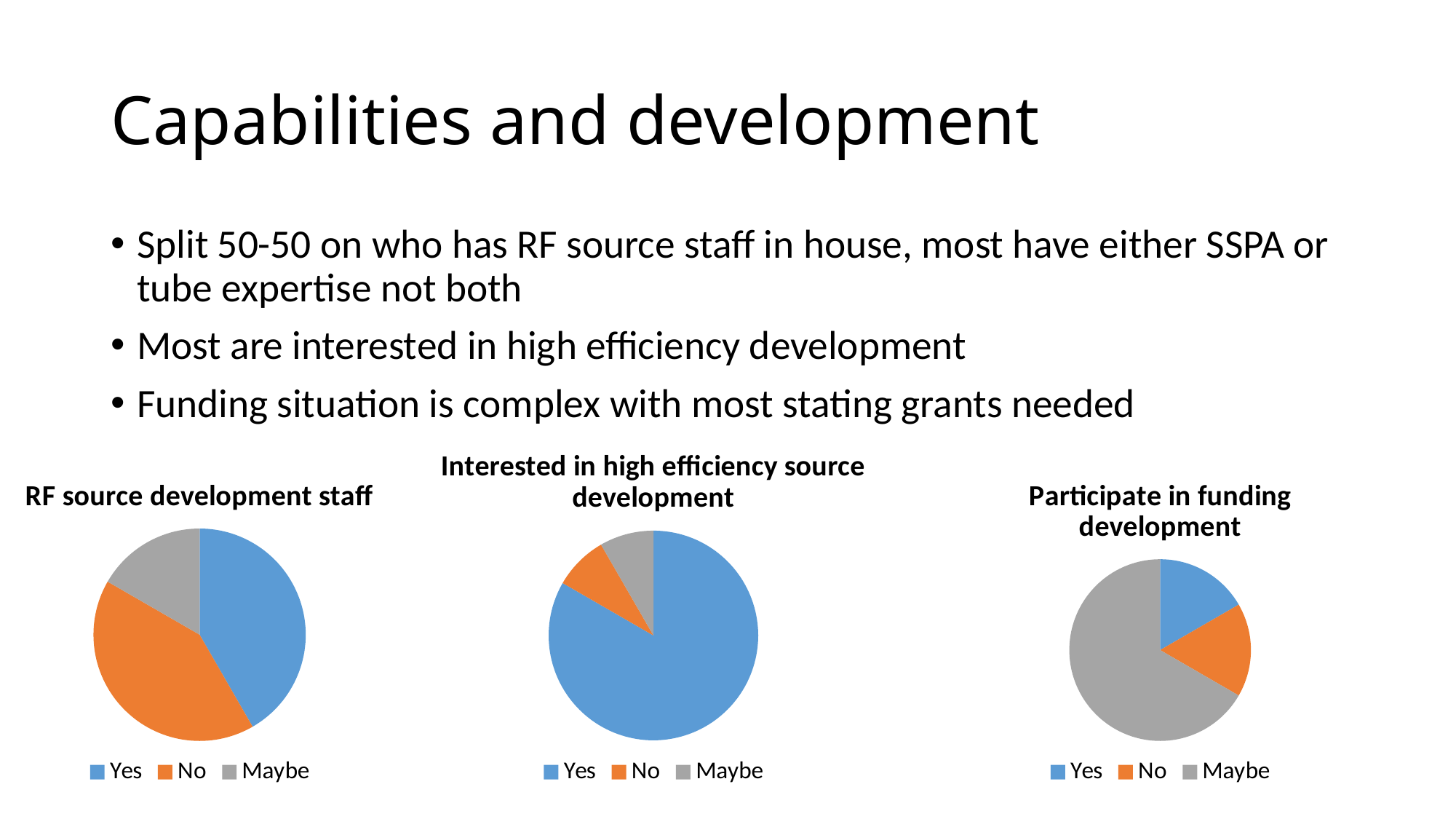
In the "RF source development staff" chart, which category has the largest slice? Yes and No (tied) How many entries does the legend of the "Interested in high efficiency source development" chart list? 3 How many categories does the "Participate in funding development" pie chart have? 3 In the "Interested in high efficiency source development" chart, which slice is larger, Yes or No? Yes In the "Interested in high efficiency source development" chart, which category has the largest slice? Yes What kind of chart is the "RF source development staff" chart? Pie chart What is the title of the leftmost chart on the slide? RF source development staff What colour represents "Maybe" in the "Participate in funding development" chart? Grey In the "RF source development staff" chart, which category has the smallest slice? Maybe In the "Participate in funding development" chart, which category has the largest slice? Maybe In the "Participate in funding development" chart, which slice is larger, Maybe or Yes? Maybe In the "RF source development staff" chart, which slice is larger, No or Maybe? No